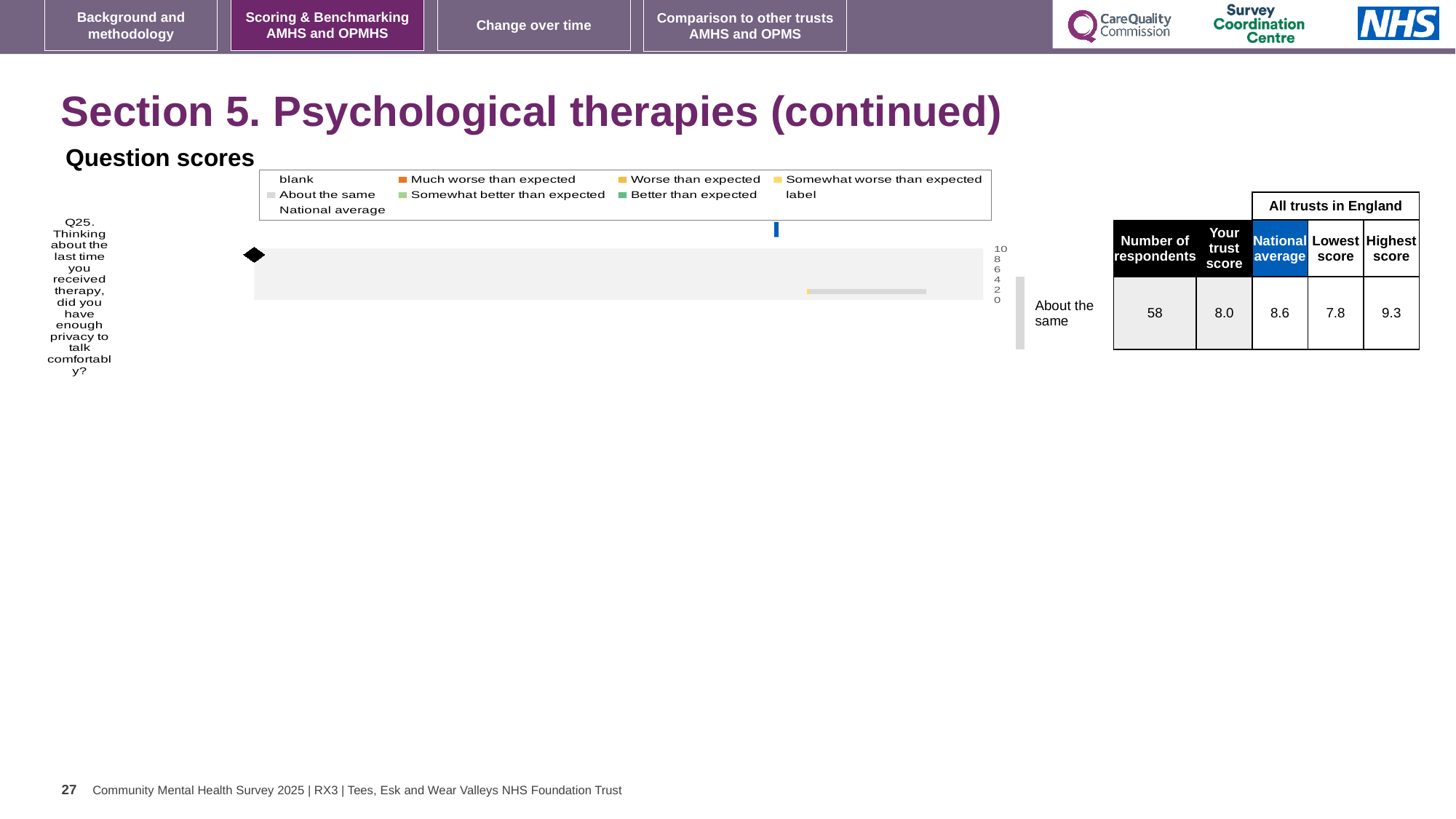
In the table next to the chart, what is the trust score for Q25? 8.0 What type of chart is shown under 'Question scores'? bar chart In the table next to the chart, what is the lowest score among all trusts in England for Q25? 7.8 For Q25, what is the difference between the highest score and the lowest score among all trusts in England? 1.5 In the table next to the chart, what is the national average for Q25? 8.6 For Q25, which is larger: the trust score or the national average? national average In the table next to the chart, what is the highest score among all trusts in England for Q25? 9.3 What is the maximum value shown on the score axis of the 'Question scores' chart? 10 Which question number is plotted in the 'Question scores' chart? Q25 How many questions are plotted in the 'Question scores' chart? 1 In the table next to the chart, how many respondents answered Q25? 58 Which benchmark category is Q25 assigned to in the 'Question scores' chart? About the same